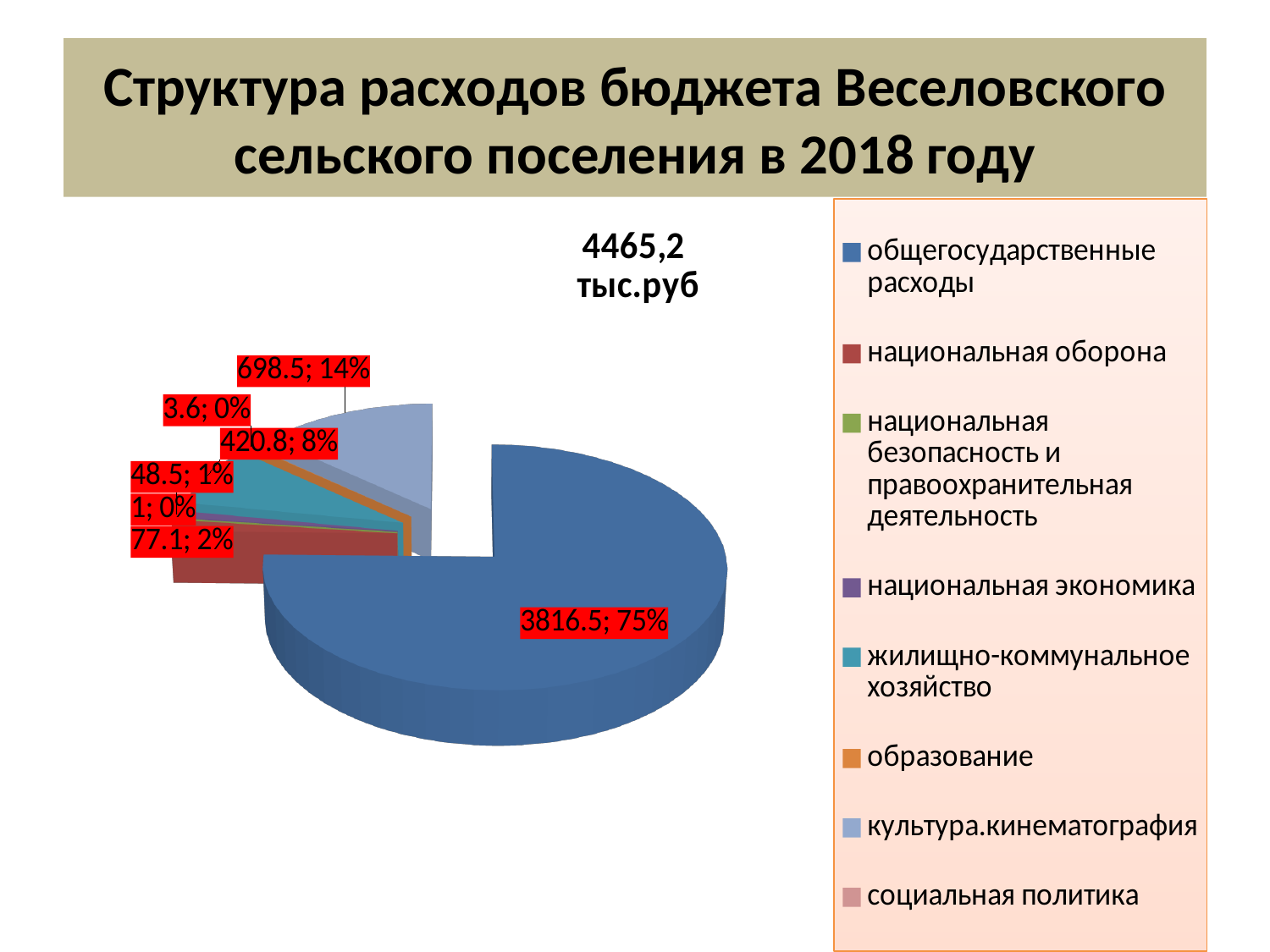
What value is labelled for жилищно-коммунальное хозяйство? 420.8 How many categories does the chart legend list? 8 What kind of chart is shown on the slide? pie chart What share of the pie does культура.кинематография take? 14% What colour is the slice for общегосударственные расходы? blue Which category has the largest slice of the pie? общегосударственные расходы What value is labelled on the largest slice (общегосударственные расходы)? 3816.5 What is the title of the chart? 4465,2 тыс.руб What is the difference between the labelled values for культура.кинематография (698.5) and жилищно-коммунальное хозяйство (420.8)? 277.7 What share of the pie does общегосударственные расходы take? 75% Which is larger, the slice for культура.кинематография or the slice for жилищно-коммунальное хозяйство? культура.кинематография What share of the pie does жилищно-коммунальное хозяйство take? 8%